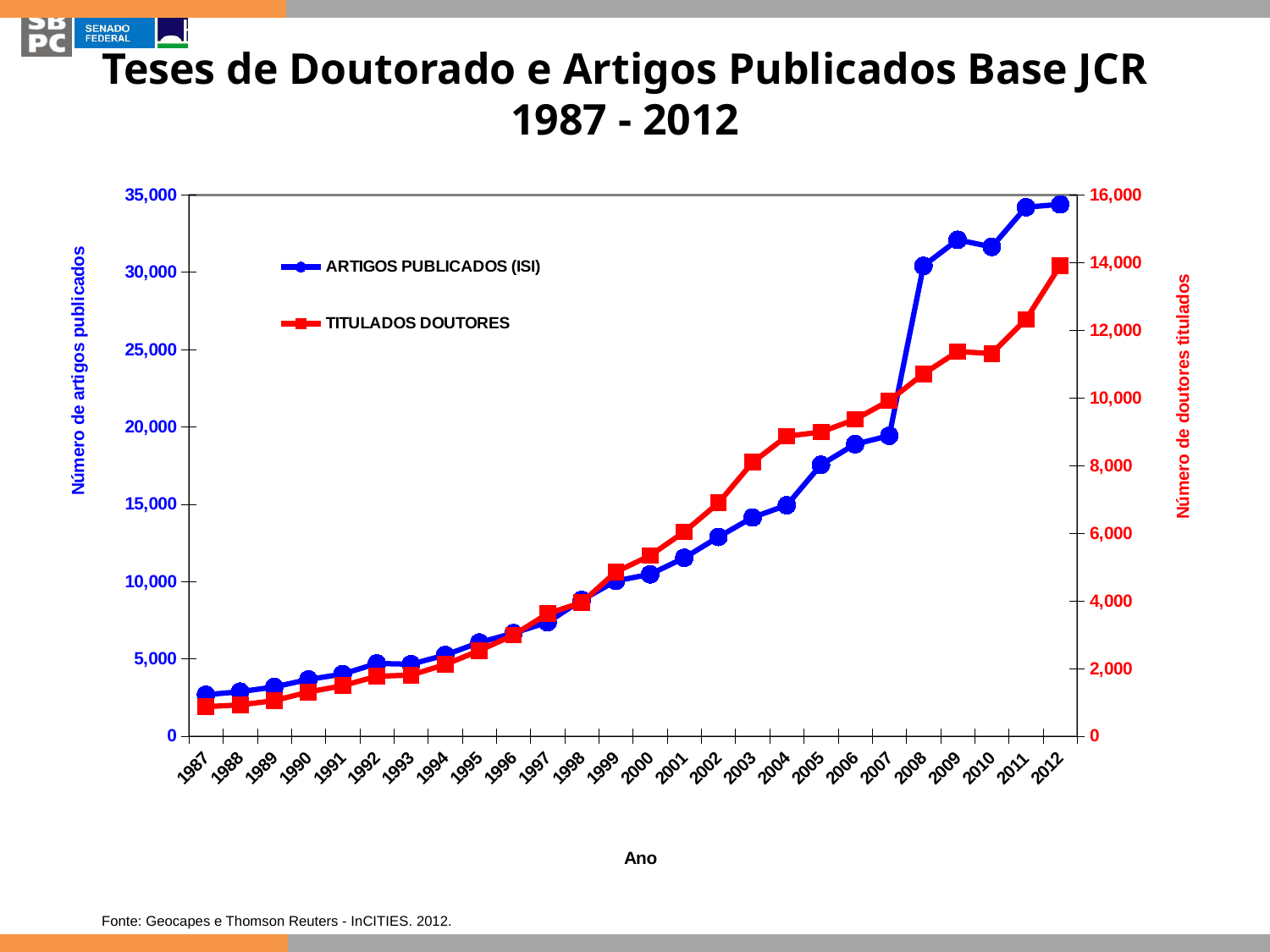
Is the ARTIGOS PUBLICADOS (ISI) value for 2005 greater or less than 20,000? less Is the ARTIGOS PUBLICADOS (ISI) value for 2009 greater or less than 30,000? greater How many years are plotted along the x axis? 26 In which year is the TITULADOS DOUTORES value lowest? 1987 How many series does the legend list? 2 Does the ARTIGOS PUBLICADOS (ISI) series generally rise or fall from 1987 to 2012? rise What kind of chart is shown on the slide? line chart Is the TITULADOS DOUTORES value for 2009 greater or less than 10,000? greater What colour is the TITULADOS DOUTORES line? red What is the label of the right-hand vertical axis? Número de doutores titulados In which year is the TITULADOS DOUTORES value highest? 2012